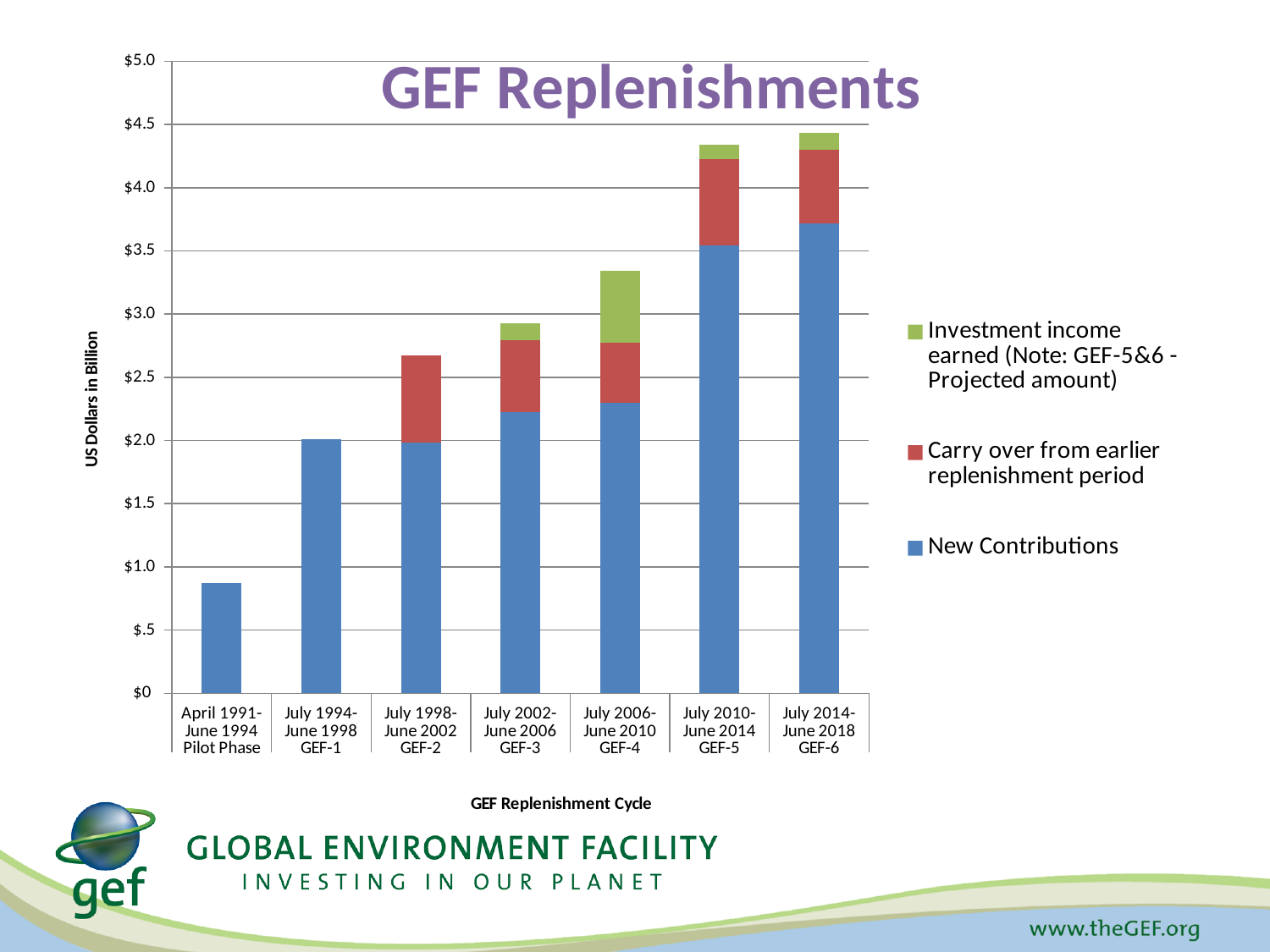
Is the total value for GEF-4 (July 2006-June 2010) greater or less than $3.0 billion? greater How many replenishment cycles (bars) are shown on the x axis? 7 What kind of chart is shown on the slide? Stacked bar chart How many series does the legend list? 3 Do the total bar heights generally rise or fall from the Pilot Phase to GEF-6? Rise Which replenishment cycle has the highest total bar? July 2014-June 2018 GEF-6 Is the total value for GEF-5 (July 2010-June 2014) greater or less than $4.0 billion? greater What is the label on the y axis of the chart? US Dollars in Billion Is the total value for the Pilot Phase (April 1991-June 1994) greater or less than $1.0 billion? less Which replenishment cycle has the lowest total bar? April 1991-June 1994 Pilot Phase Which has the larger total bar, GEF-3 (July 2002-June 2006) or GEF-4 (July 2006-June 2010)? GEF-4 (July 2006-June 2010)